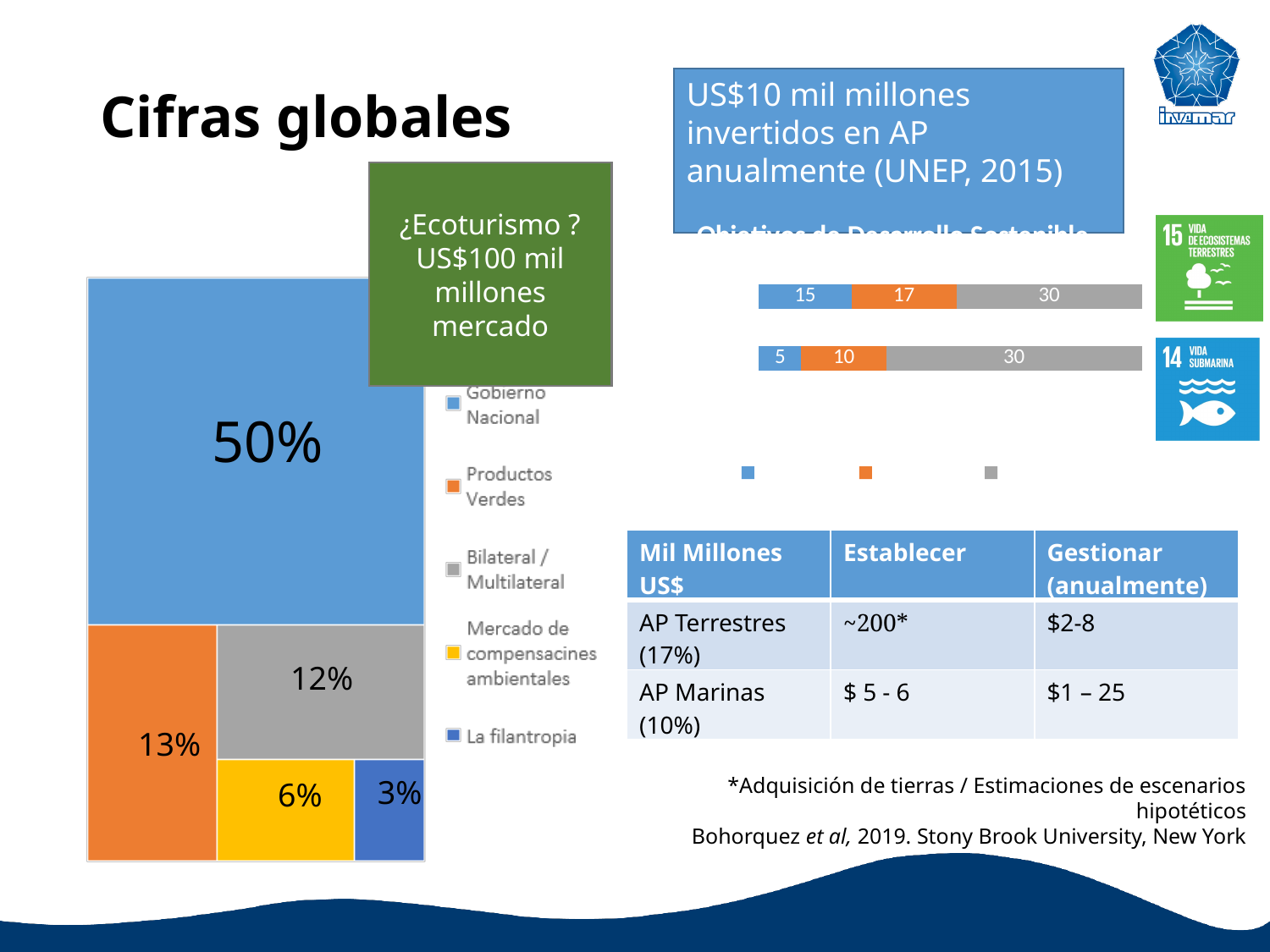
In the stacked bar chart on the right, what is the total of the top bar (15, 17 and 30)? 62 In the treemap chart on the left, which category has the smallest share? La filantropia In the treemap chart on the left, what percentage is shown for Productos Verdes? 13% In the treemap chart on the left, what percentage is shown for Bilateral / Multilateral? 12% In the stacked bar chart on the right, what is the value of the first (blue) segment of the top bar? 15 In the treemap chart on the left, what percentage is shown for Gobierno Nacional? 50% In the treemap chart on the left, how many categories does the legend list? 5 In the treemap chart on the left, which category has the largest share? Gobierno Nacional In the stacked bar chart on the right, what is the total of the bottom bar (5, 10 and 30)? 45 In the treemap chart on the left, which colour represents Mercado de compensaciones ambientales? Yellow In the treemap chart on the left, what is the difference between the shares of Productos Verdes and Mercado de compensaciones ambientales? 7% In the treemap chart on the left, what percentage is shown for La filantropia? 3%